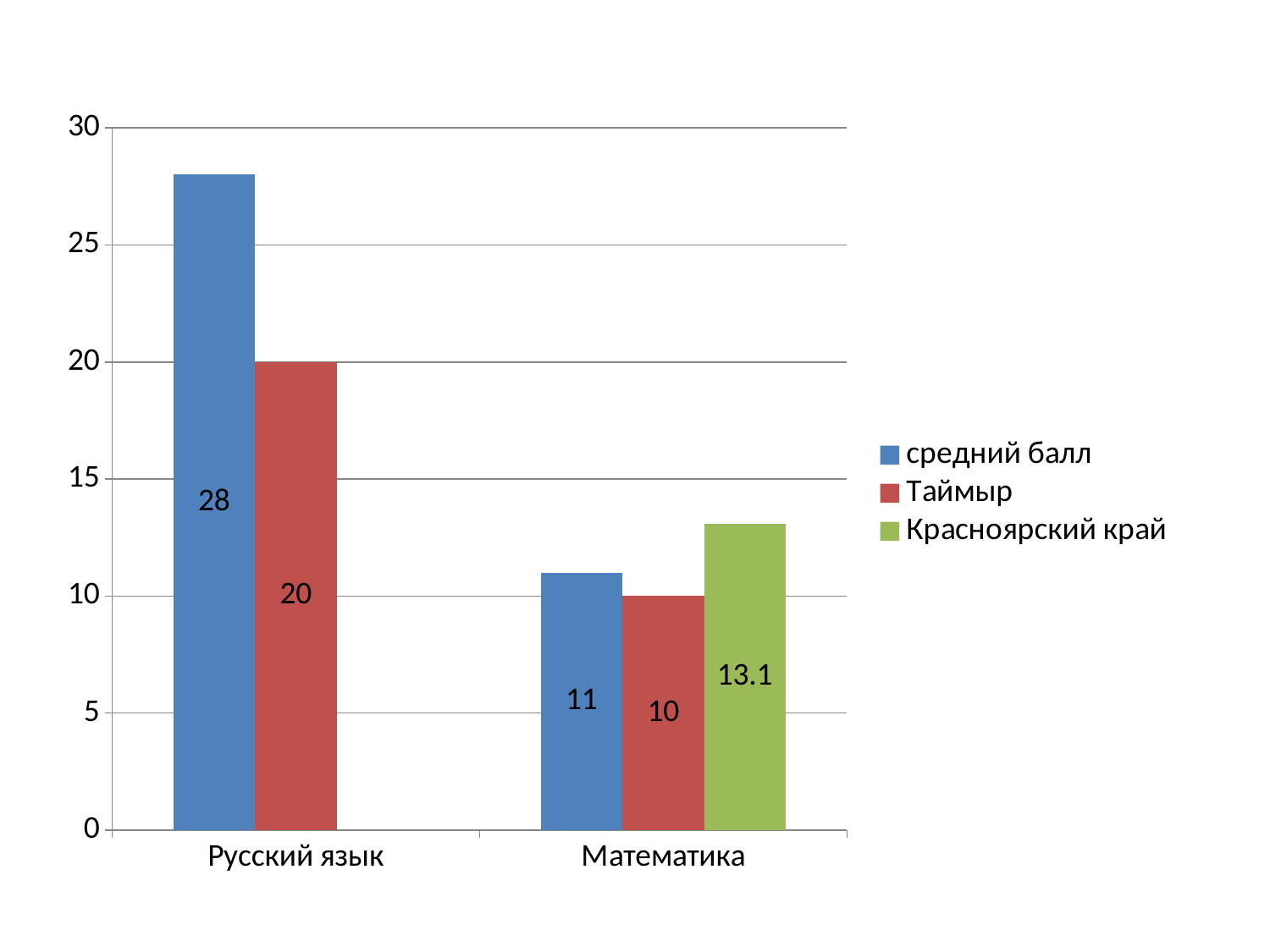
Which series has the highest value for Математика? Красноярский край What is the difference between средний балл and Таймыр for Русский язык? 8 What is the value of Красноярский край for Математика? 13.1 How many series does the legend list? 3 Which is larger for Математика: средний балл or Таймыр? средний балл What is the value of Таймыр for Русский язык? 20 What kind of chart is shown on the slide? bar chart Which series has the lowest value for Математика? Таймыр Is the value of средний балл for Русский язык greater or less than 25? greater What is the value of Таймыр for Математика? 10 What is the value of средний балл for Русский язык? 28 How many categories are shown on the x axis? 2